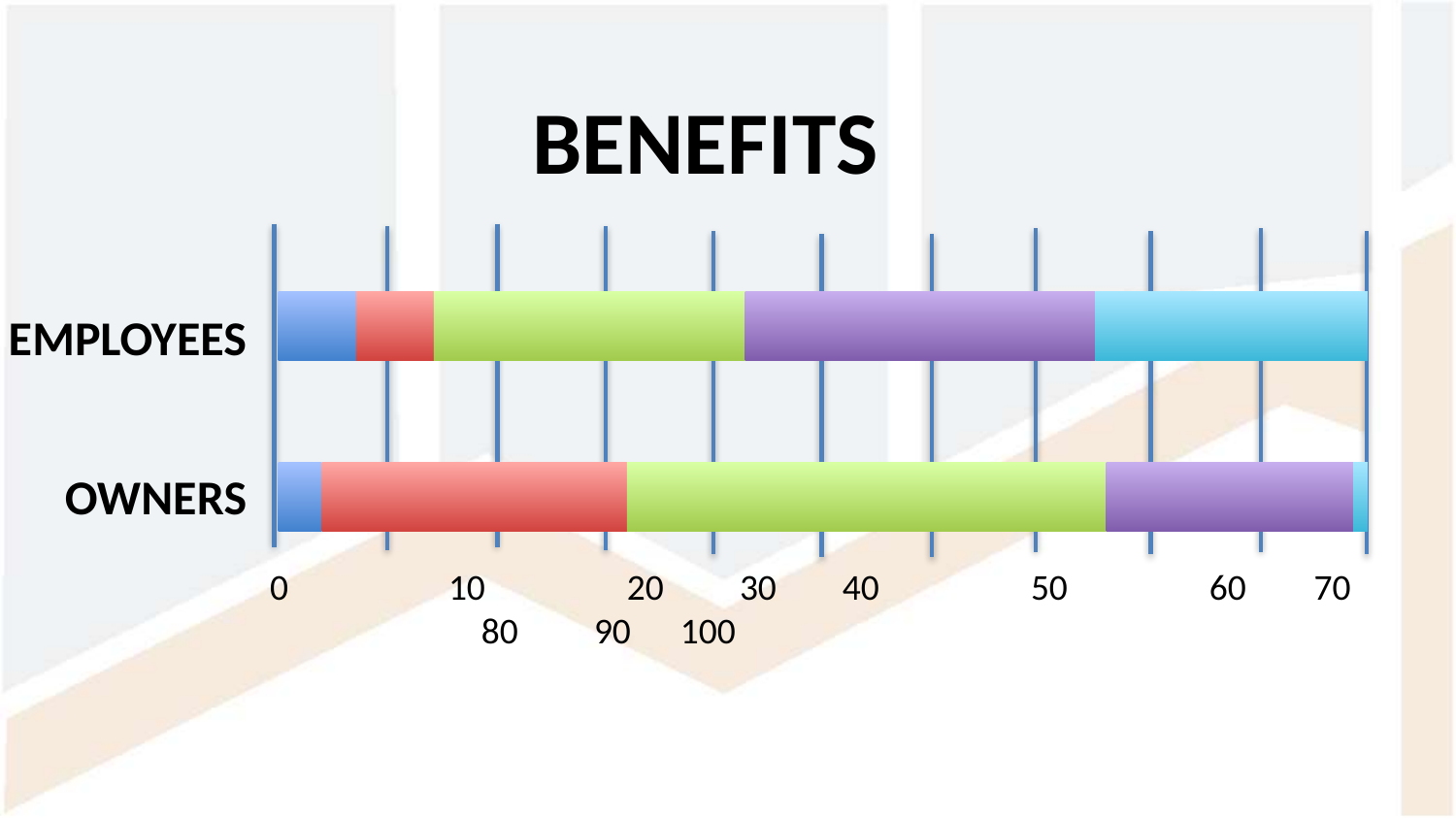
Which category has the larger dark blue segment, EMPLOYEES or OWNERS? EMPLOYEES Which category has the larger green segment, EMPLOYEES or OWNERS? OWNERS Which category has the larger light blue segment, EMPLOYEES or OWNERS? EMPLOYEES What is the title of the chart? BENEFITS What kind of chart is shown on the slide? stacked bar chart How many categories are plotted on the chart? 2 How many coloured segments make up each bar? 5 Which category is listed at the top of the chart? EMPLOYEES